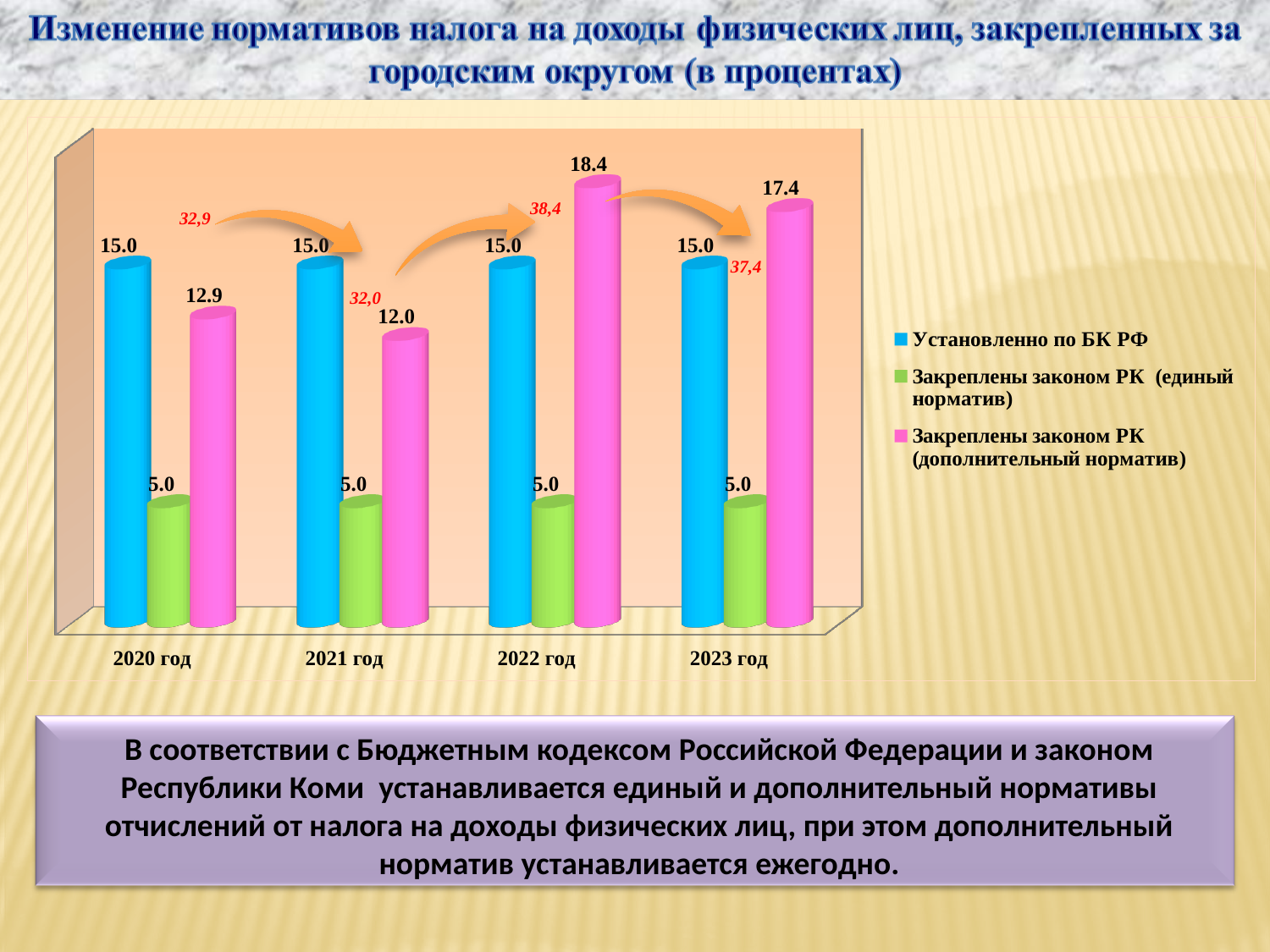
Which colour represents the 'Закреплены законом РК (единый норматив)' series in the chart? Green How many years are shown on the x axis of the chart? 4 What is the difference between the 'Закреплены законом РК (дополнительный норматив)' values for 2022 год and 2023 год? 1.0 Which is larger for 2021 год: the 'Установленно по БК РФ' value or the 'Закреплены законом РК (дополнительный норматив)' value? Установленно по БК РФ How many series does the chart legend list? 3 What is the value of the 'Закреплены законом РК (дополнительный норматив)' series for 2022 год? 18.4 What is the value of the 'Закреплены законом РК (дополнительный норматив)' series for 2020 год? 12.9 In which year is the 'Закреплены законом РК (дополнительный норматив)' value lowest? 2021 год What is the value of the 'Установленно по БК РФ' series for 2023 год? 15.0 In which year is the 'Закреплены законом РК (дополнительный норматив)' value highest? 2022 год What is the value of the 'Закреплены законом РК (единый норматив)' series for 2021 год? 5.0 What kind of chart is shown on the slide? Bar chart